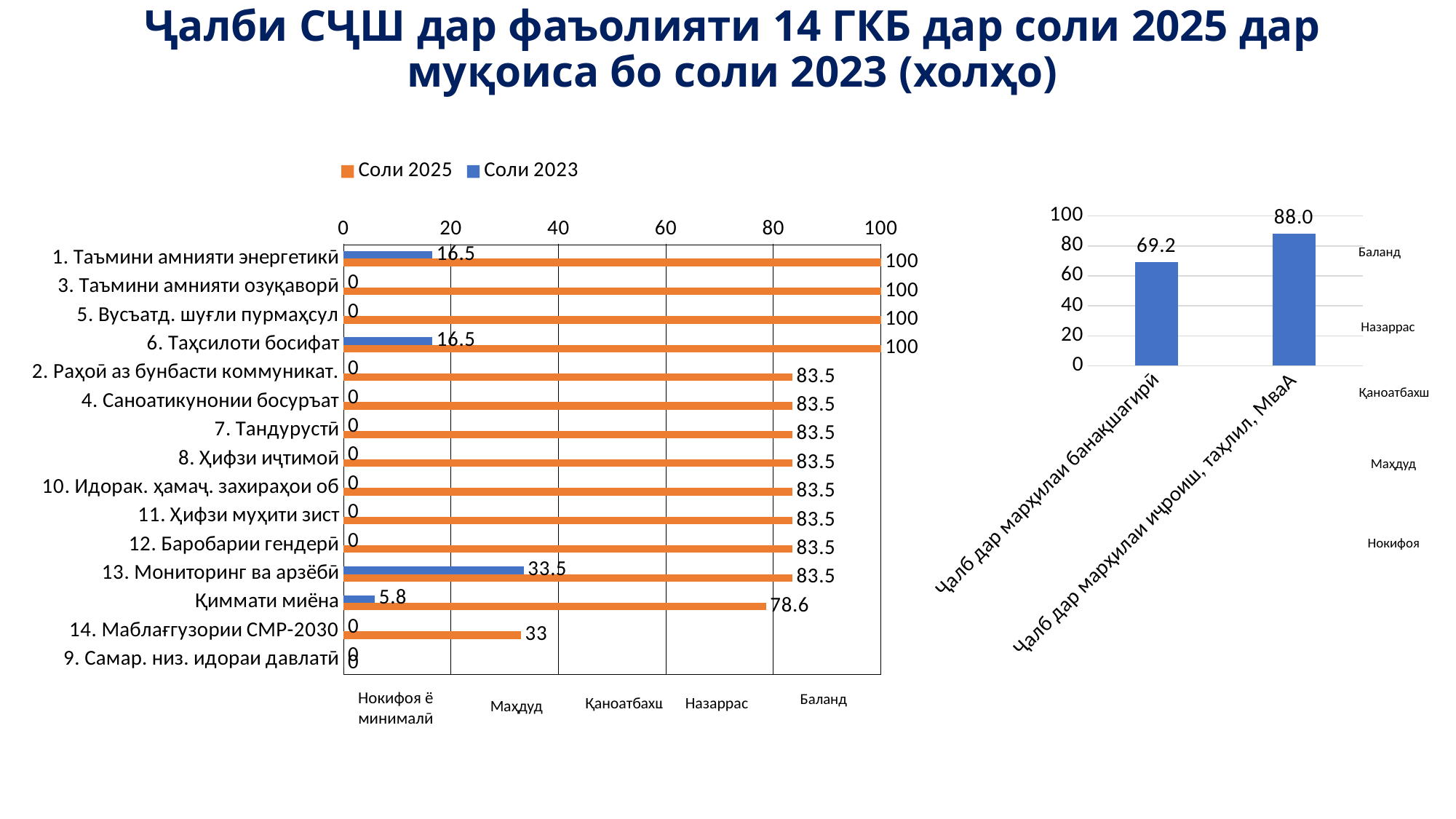
In the left chart, what is the value for Соли 2023 for 13. Мониторинг ва арзёбӣ? 33.5 In the right chart, what is the value for Ҷалб дар марҳилаи иҷроиш, таҳлил, МваА? 88.0 In the left chart, what is the difference between the Соли 2025 and Соли 2023 values for Қиммати миёна? 72.8 In the left chart, what is the value for Соли 2025 for Қиммати миёна? 78.6 In the left chart, what is the value for Соли 2025 for 14. Маблағгузории СМР-2030? 33 In the left chart, what is the value for Соли 2023 for 1. Таъмини амнияти энергетикӣ? 16.5 In the left chart, how many series does the legend list? 2 In the right chart, what is the difference between the two bars? 18.8 In the left chart, what is the value for Соли 2025 for 13. Мониторинг ва арзёбӣ? 83.5 In the left chart, how many categories are shown? 15 What kind of chart is the right chart? Bar chart In the left chart, which category has the highest Соли 2023 value? 13. Мониторинг ва арзёбӣ